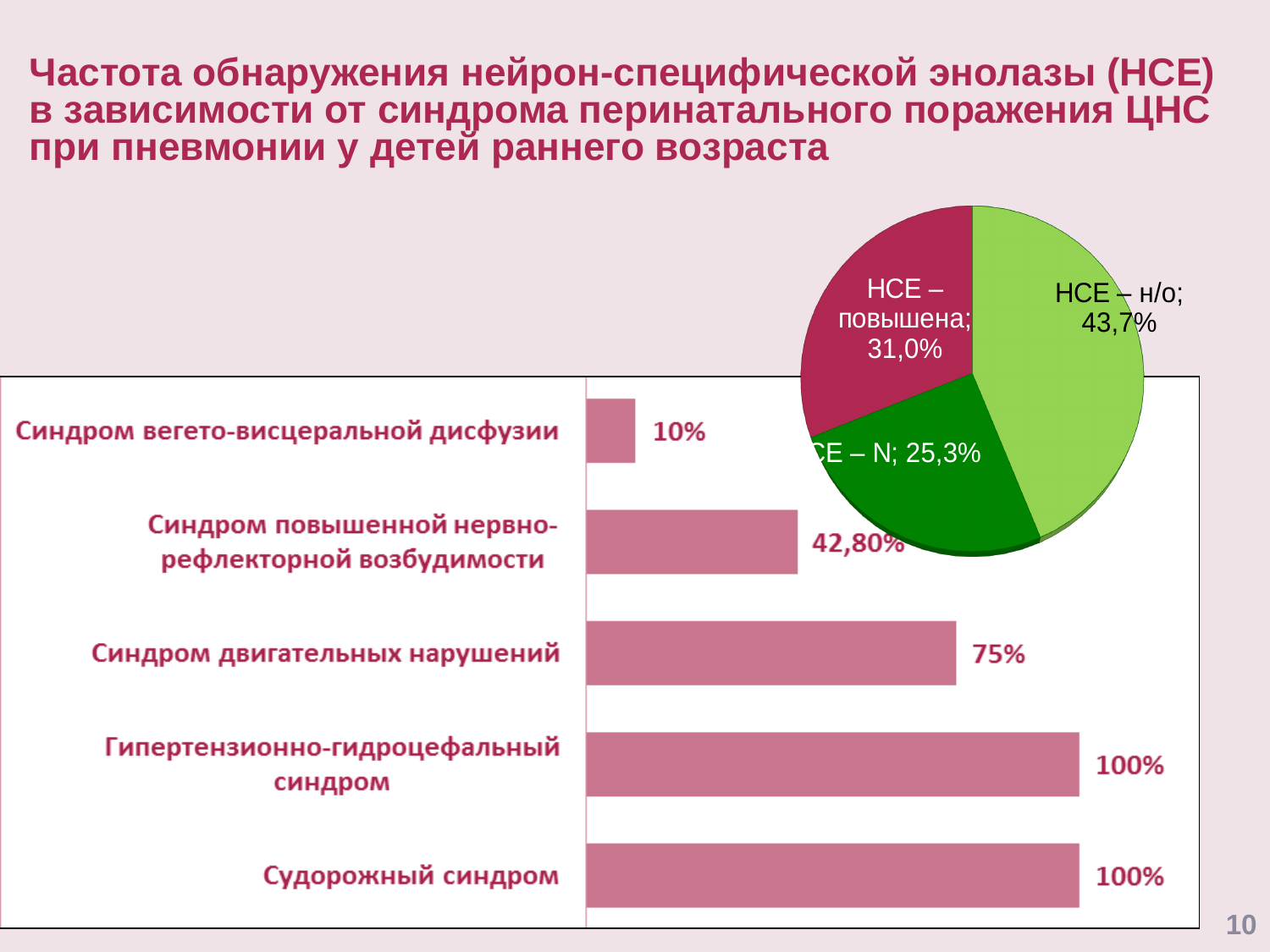
In the bar chart, how many categories are shown? 5 In the bar chart, which category has the lowest value? Синдром вегето-висцеральной дисфузии In the bar chart, what is the difference between the values for Синдром двигательных нарушений and Синдром вегето-висцеральной дисфузии? 65% In the pie chart, what is the share for НСЕ – н/о? 43,7% In the pie chart, what is the share for НСЕ – повышена? 31,0% What kind of chart is the chart at the bottom of the slide? Bar chart In the bar chart, what is the value for Синдром повышенной нервно-рефлекторной возбудимости? 42,80% In the bar chart, what is the value for Синдром двигательных нарушений? 75% In the bar chart, which is larger: the value for Судорожный синдром or the value for Синдром двигательных нарушений? Судорожный синдром In the bar chart, what is the value for Синдром вегето-висцеральной дисфузии? 10% How many slices does the pie chart have? 3 In the pie chart, which slice is the largest? НСЕ – н/о